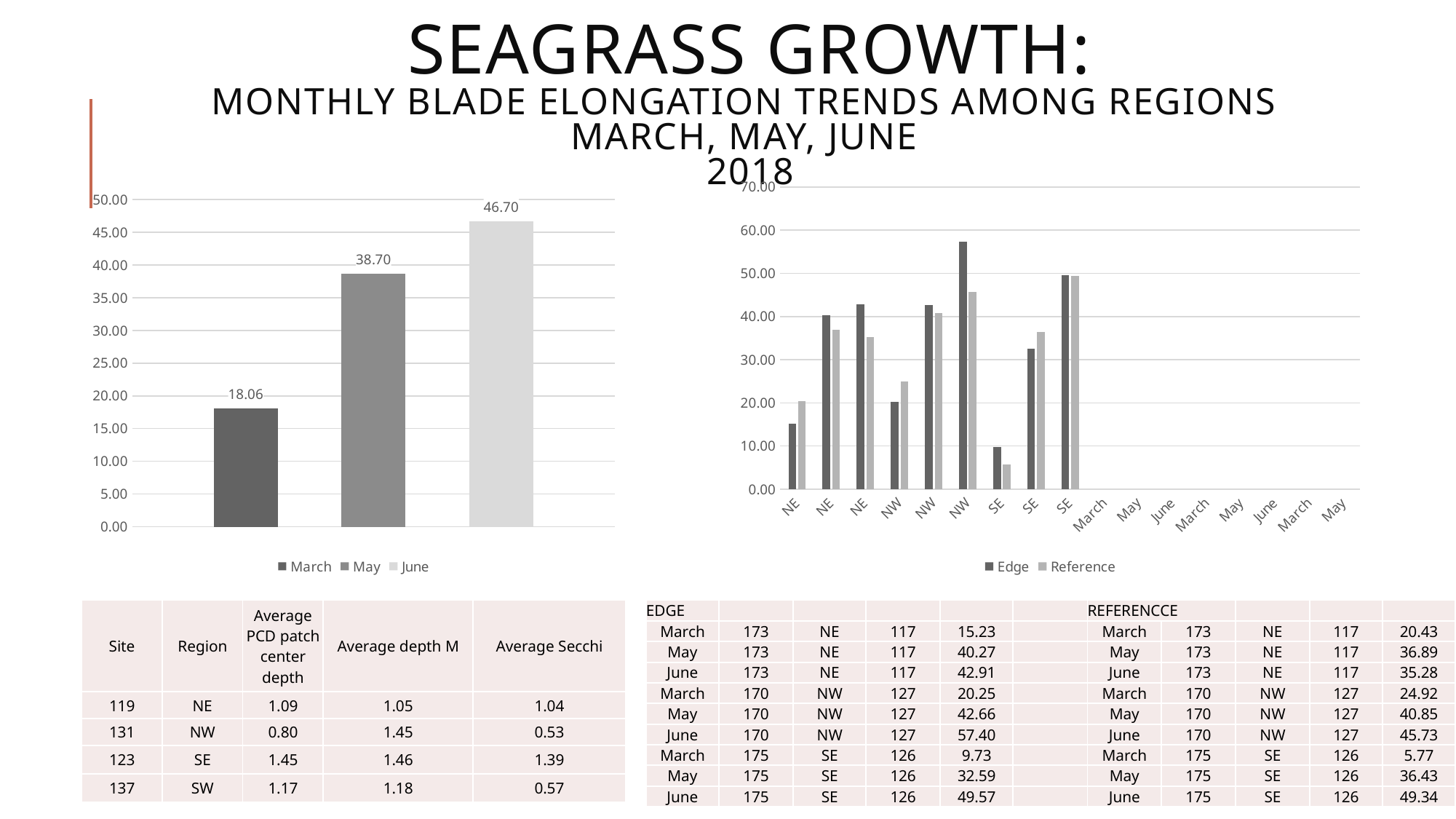
In the right chart, is the Edge value for the first NE category greater or less than 20.00? less In the left chart, what is the value for March? 18.06 In the left chart, do the values rise or fall from left to right? rise In the right chart, is the Edge value for the third NW category greater or less than 50.00? greater In the left chart, how many bars are plotted? 3 In the left chart, which month has the highest value? June What kind of chart is the chart on the right? bar chart In the left chart, what is the difference between the tallest bar (46.70) and the middle bar (38.70)? 8.00 In the left chart, what is the value for June? 46.70 In the left chart, what is the difference between the June value and the March value? 28.64 In the left chart, which month has the lowest value? March In the right chart, how many series does the legend list? 2